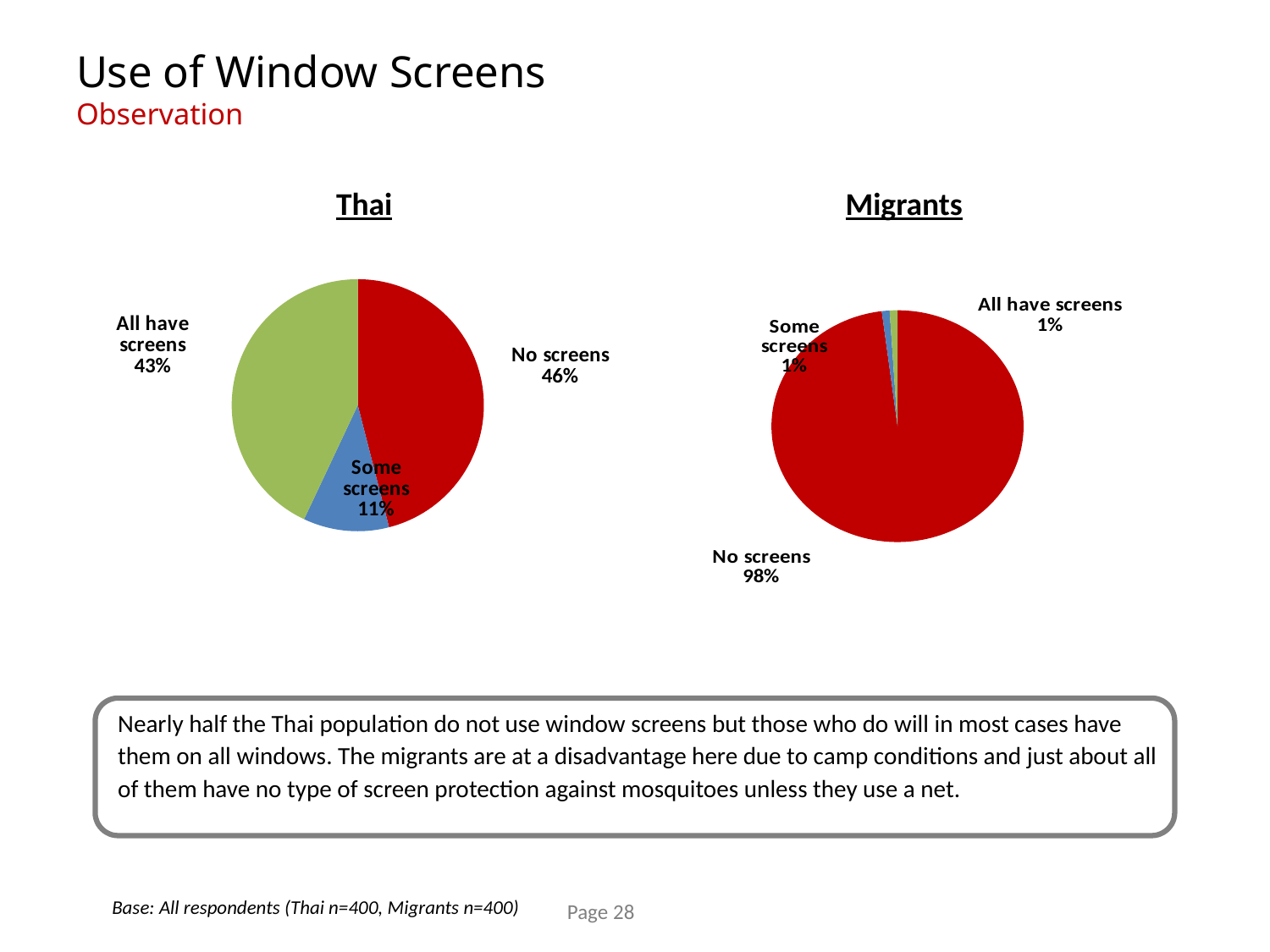
In the Migrants pie chart, what share of respondents have no screens? 98% In the Thai pie chart, what share of respondents have screens on all windows? 43% In the Thai pie chart, what is the difference between the No screens share and the All have screens share? 3% How many categories does the Thai pie chart show? 3 In the Thai pie chart, what share of respondents have some screens? 11% In the Thai pie chart, which category has the largest share? No screens What type of chart is used for the Thai and Migrants data? Pie chart Which is larger: the No screens share in the Thai chart or the No screens share in the Migrants chart? Migrants In the Thai pie chart, what share of respondents have no screens? 46% In the Migrants pie chart, which category has the largest share? No screens In the Thai pie chart, which category has the smallest share? Some screens In the Migrants pie chart, what share of respondents have all screens? 1%